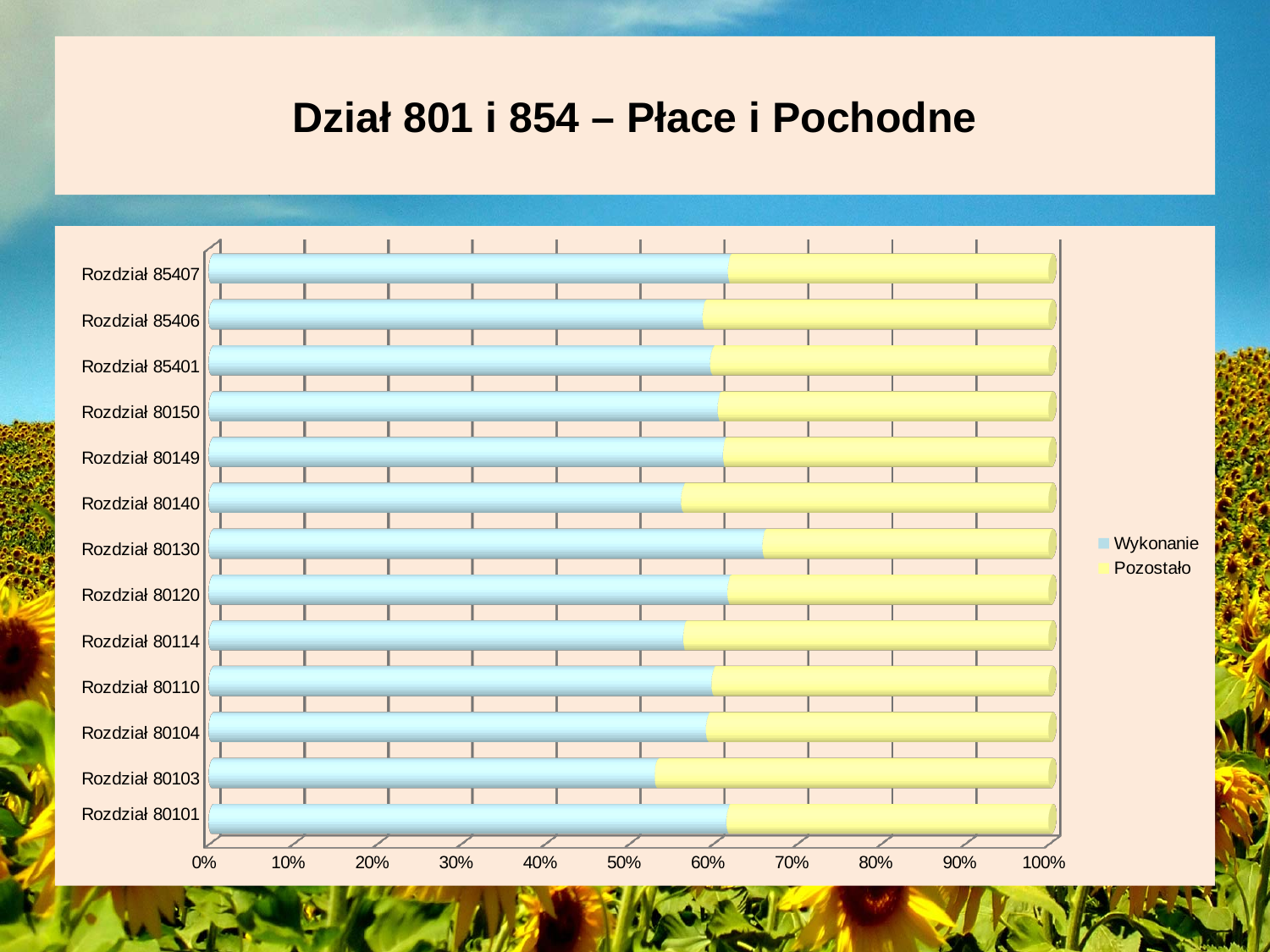
How many series does the legend list? 2 Which category has the highest Wykonanie share? Rozdział 80130 What are the two series named in the legend? Wykonanie and Pozostało What is the title of the slide containing the chart? Dział 801 i 854 – Płace i Pochodne Is the Wykonanie value for Rozdział 80130 greater or less than 60%? greater How many categories (Rozdział entries) are plotted on the chart? 13 Is the Wykonanie value for Rozdział 80130 greater or less than 70%? less Which category has the lowest Wykonanie share? Rozdział 80103 Which has the larger Wykonanie share, Rozdział 80130 or Rozdział 80103? Rozdział 80130 Is the Wykonanie value for Rozdział 80103 greater or less than 60%? less What kind of chart is shown on the slide? bar chart Which has the larger Pozostało share, Rozdział 80103 or Rozdział 80130? Rozdział 80103